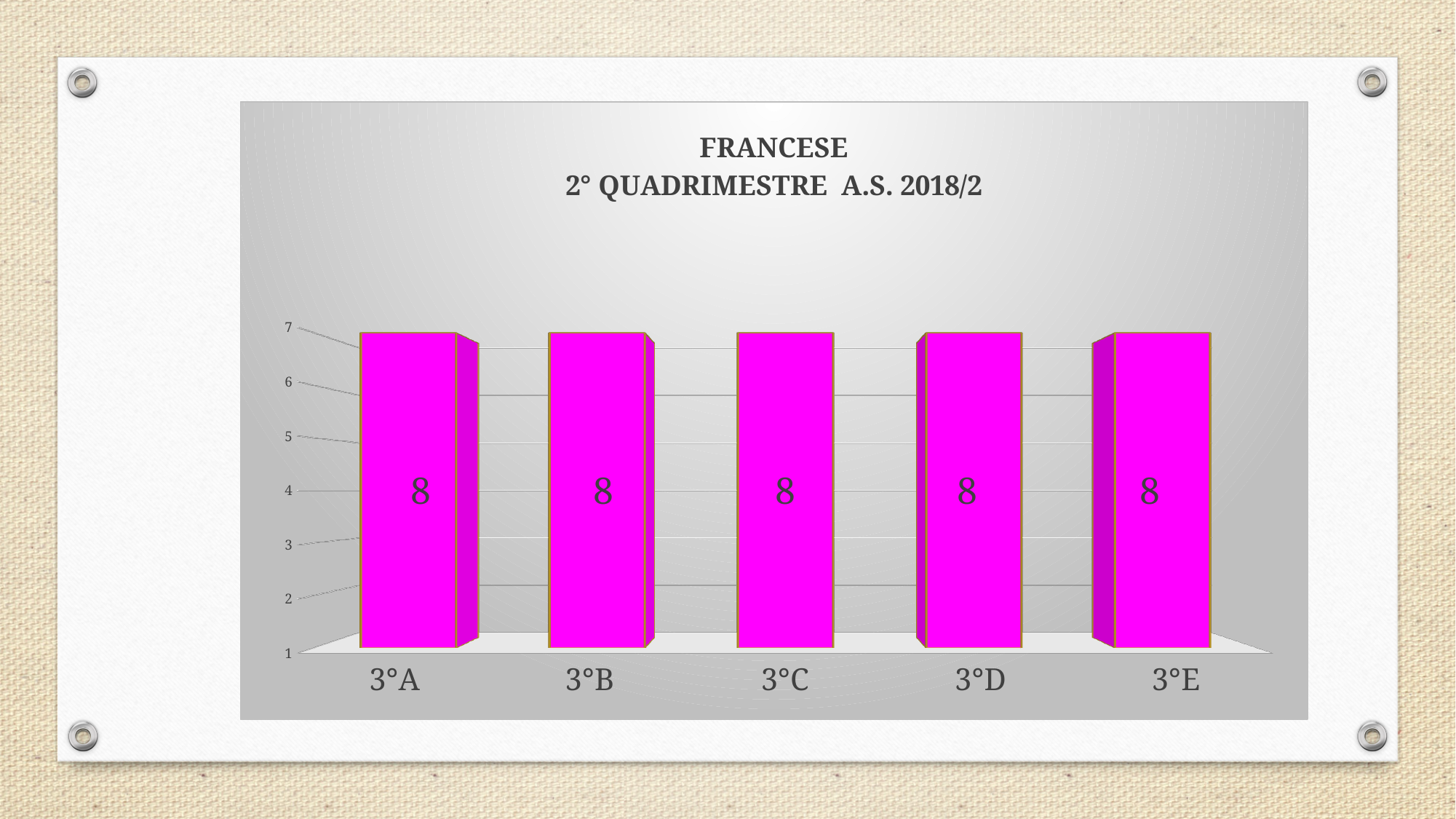
How many categories are shown on the x axis? 5 Do the values rise, fall or stay the same from 3°A to 3°E? Stay the same What is the difference between the values for 3°A and 3°E? 0 What kind of chart is shown on the slide? Bar chart What is the value for 3°D? 8 What is the value for 3°A? 8 What is the value for 3°B? 8 Is the value for 3°C greater or less than 5? greater What colour are the bars in the chart? Magenta What is the value for 3°E? 8 What is the value for 3°C? 8 What is the title of the chart? FRANCESE 2° QUADRIMESTRE A.S. 2018/2